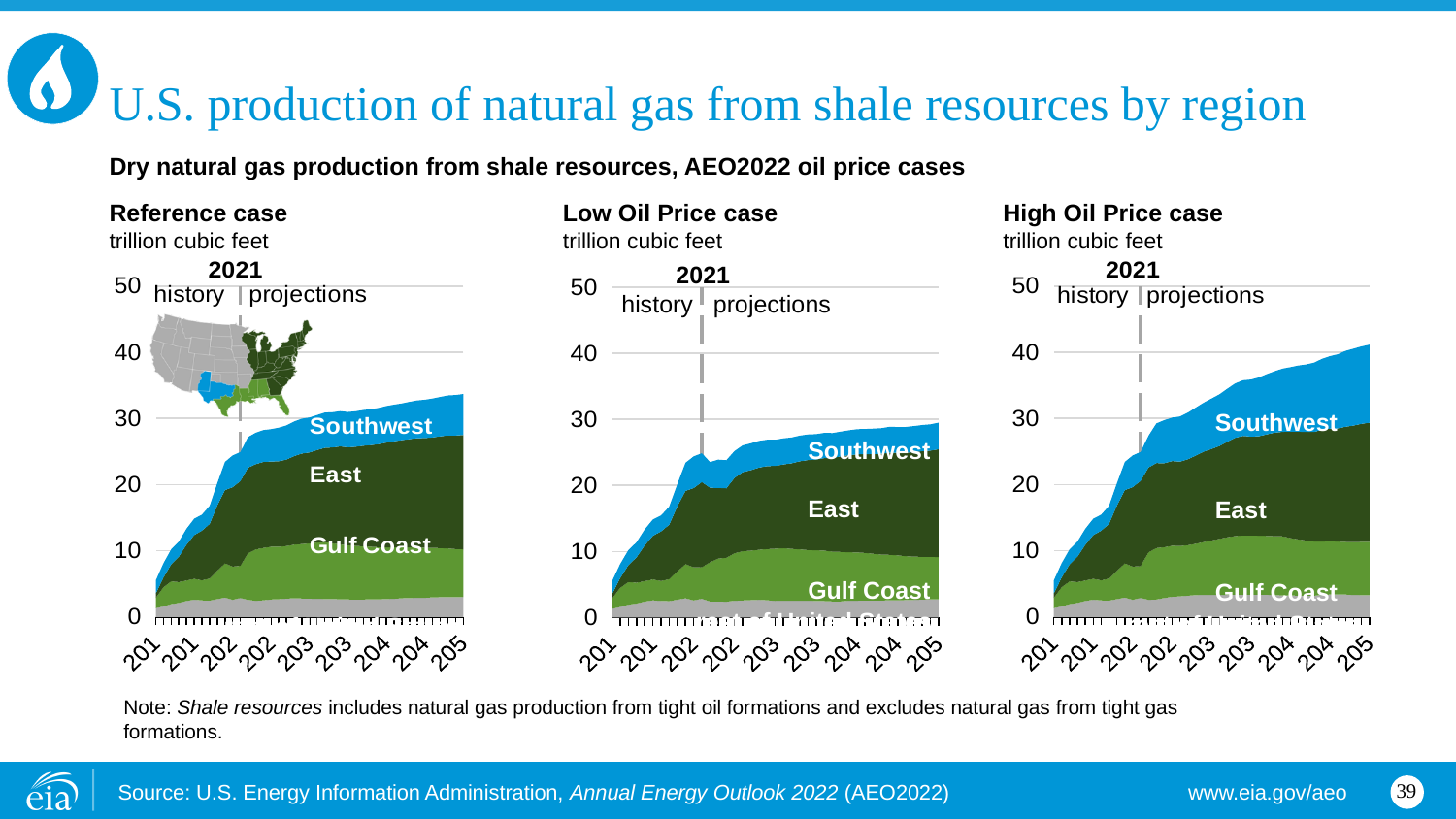
What kind of chart is used in the Reference case panel? stacked area chart Which of the three cases shows the highest total shale gas production in 2050? High Oil Price case How many charts are shown on the slide? 3 Which of the three cases shows the lowest total shale gas production in 2050? Low Oil Price case In the Reference case chart, is the total shale gas production at the end of the projection (2050) greater or less than 30 trillion cubic feet? greater In the High Oil Price case chart, is the total shale gas production in 2050 greater or less than 35 trillion cubic feet? greater How many named regions are labeled within the Reference case chart? 3 In the Reference case chart, is the total shale gas production in 2050 greater or less than 40 trillion cubic feet? less Which region is plotted as the top (blue) layer in each chart? Southwest What unit is used on the y axis of the three charts? trillion cubic feet In the High Oil Price case chart, does total shale gas production generally rise or fall over the projection period? rise